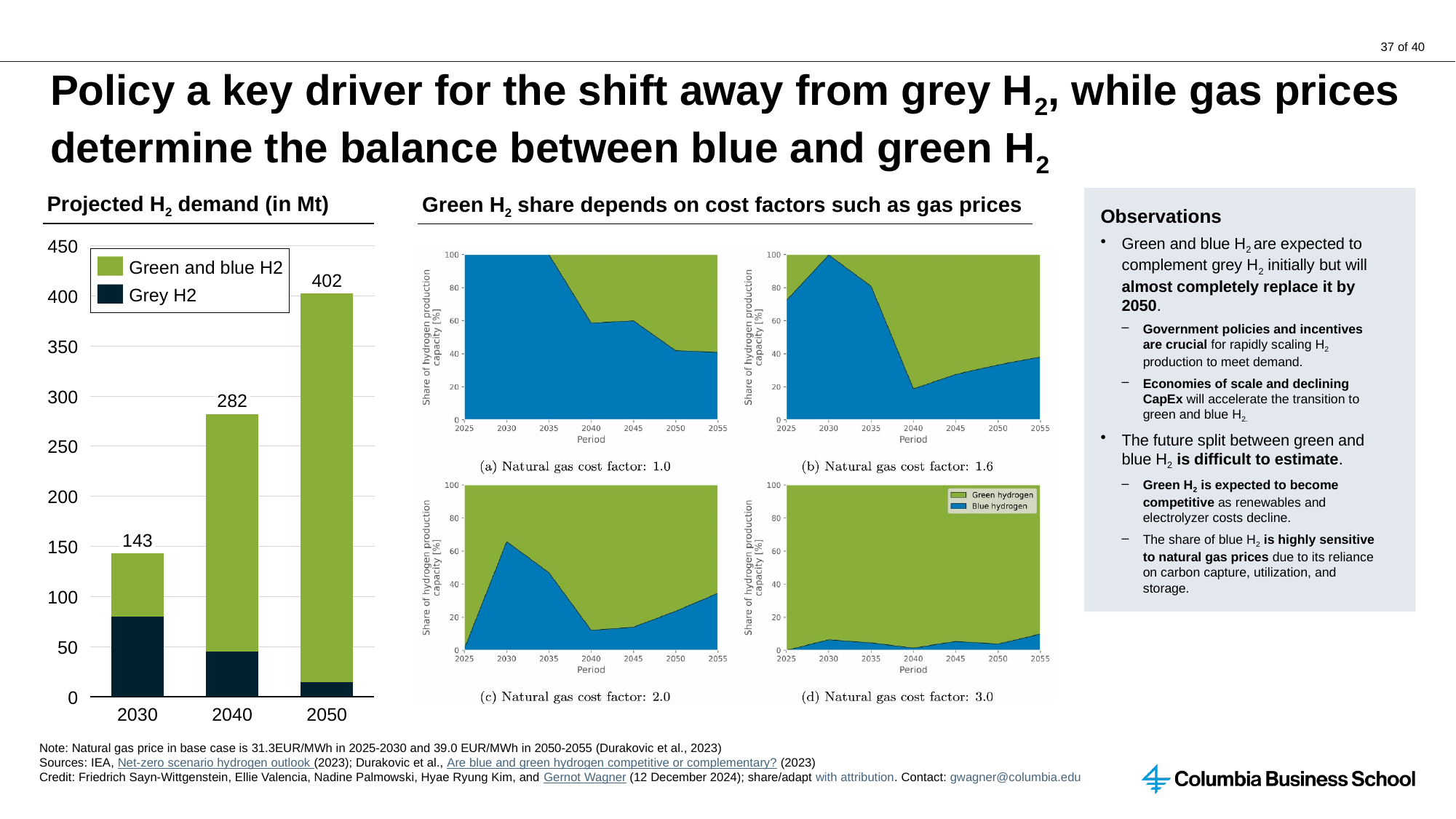
In the 'Projected H2 demand (in Mt)' chart, how many series does the legend list? 2 In the 'Projected H2 demand (in Mt)' chart, which year has the highest total H2 demand? 2050 What kind of chart is the 'Projected H2 demand (in Mt)' chart? Stacked bar chart In the 'Projected H2 demand (in Mt)' chart, does total H2 demand rise or fall from 2030 to 2050? Rise In the 'Projected H2 demand (in Mt)' chart, what is the difference between the total demand in 2050 and in 2030? 259 In the 'Projected H2 demand (in Mt)' chart, which year has the lowest total H2 demand? 2030 In the 'Projected H2 demand (in Mt)' chart, is the Grey H2 value for 2030 greater or less than 50? greater In the 'Projected H2 demand (in Mt)' chart, how many years are shown on the x axis? 3 In the 'Projected H2 demand (in Mt)' chart, is the Grey H2 value for 2050 greater or less than 50? less In panel (a) 'Natural gas cost factor: 1.0' of the 'Green H2 share depends on cost factors such as gas prices' charts, is the blue hydrogen share in 2050 greater or less than 60? less In the 'Projected H2 demand (in Mt)' chart, what is the total projected H2 demand for 2040? 282 In the 'Projected H2 demand (in Mt)' chart, what is the total projected H2 demand for 2050? 402